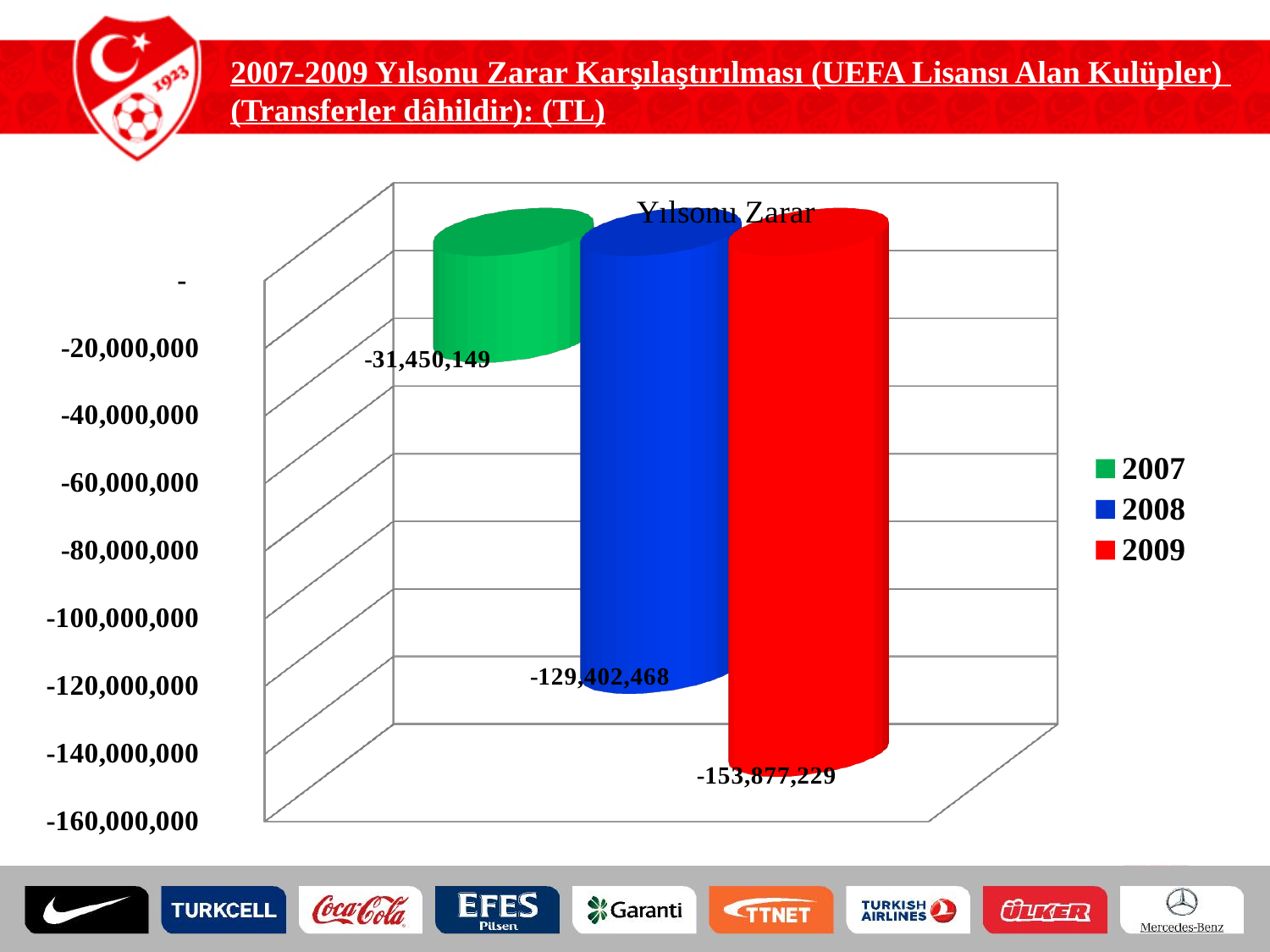
Does the year-end loss grow or shrink from 2007 to 2009? grows What is the value for 2009 in the chart? -153,877,229 How many series does the legend list? 3 Which year has the larger loss, 2007 or 2008? 2008 What kind of chart is shown on the slide? bar chart Which year shows the smallest year-end loss? 2007 By how much does the loss for 2009 exceed the loss for 2008? 24,474,761 Which year shows the largest year-end loss? 2009 What is the value for 2007 in the chart? -31,450,149 Is the value for 2008 greater or less than -100,000,000? less What is the value for 2008 in the chart? -129,402,468 By how much does the loss for 2008 exceed the loss for 2007? 97,952,319